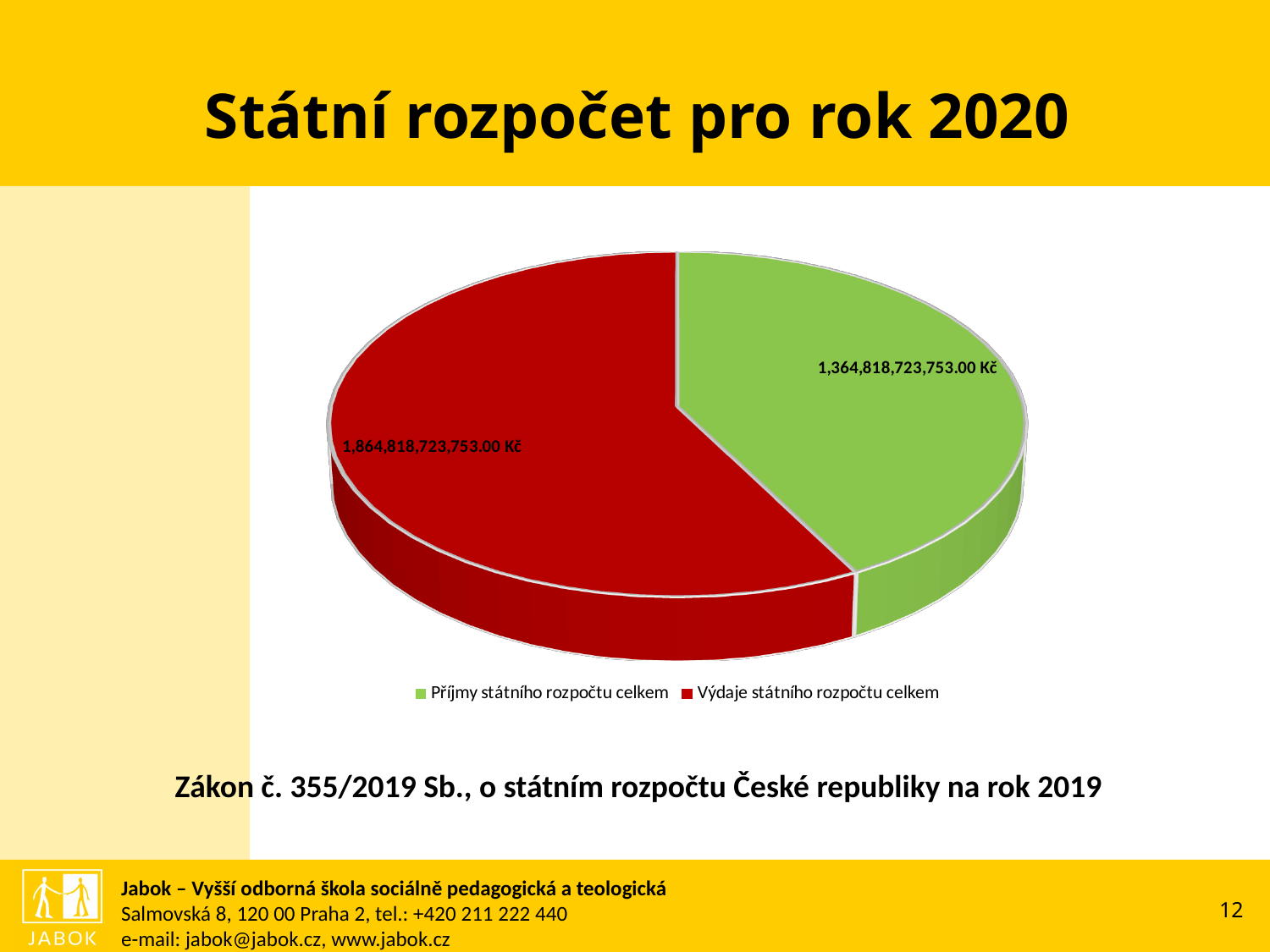
Which slice of the pie chart is the smallest? Příjmy státního rozpočtu celkem What is the value for Výdaje státního rozpočtu celkem? 1,864,818,723,753.00 Kč Which is larger, Příjmy státního rozpočtu celkem or Výdaje státního rozpočtu celkem? Výdaje státního rozpočtu celkem What colour is the slice for Výdaje státního rozpočtu celkem? Red Which slice of the pie chart is the largest? Výdaje státního rozpočtu celkem How many slices does the pie chart have? 2 What is the total of the two values shown in the pie chart? 3,229,637,447,506.00 Kč What is the difference between Výdaje státního rozpočtu celkem and Příjmy státního rozpočtu celkem? 500,000,000,000.00 Kč What is the value for Příjmy státního rozpočtu celkem? 1,364,818,723,753.00 Kč How many entries does the legend list? 2 What type of chart is shown on the slide? Pie chart What colour is the slice for Příjmy státního rozpočtu celkem? Green